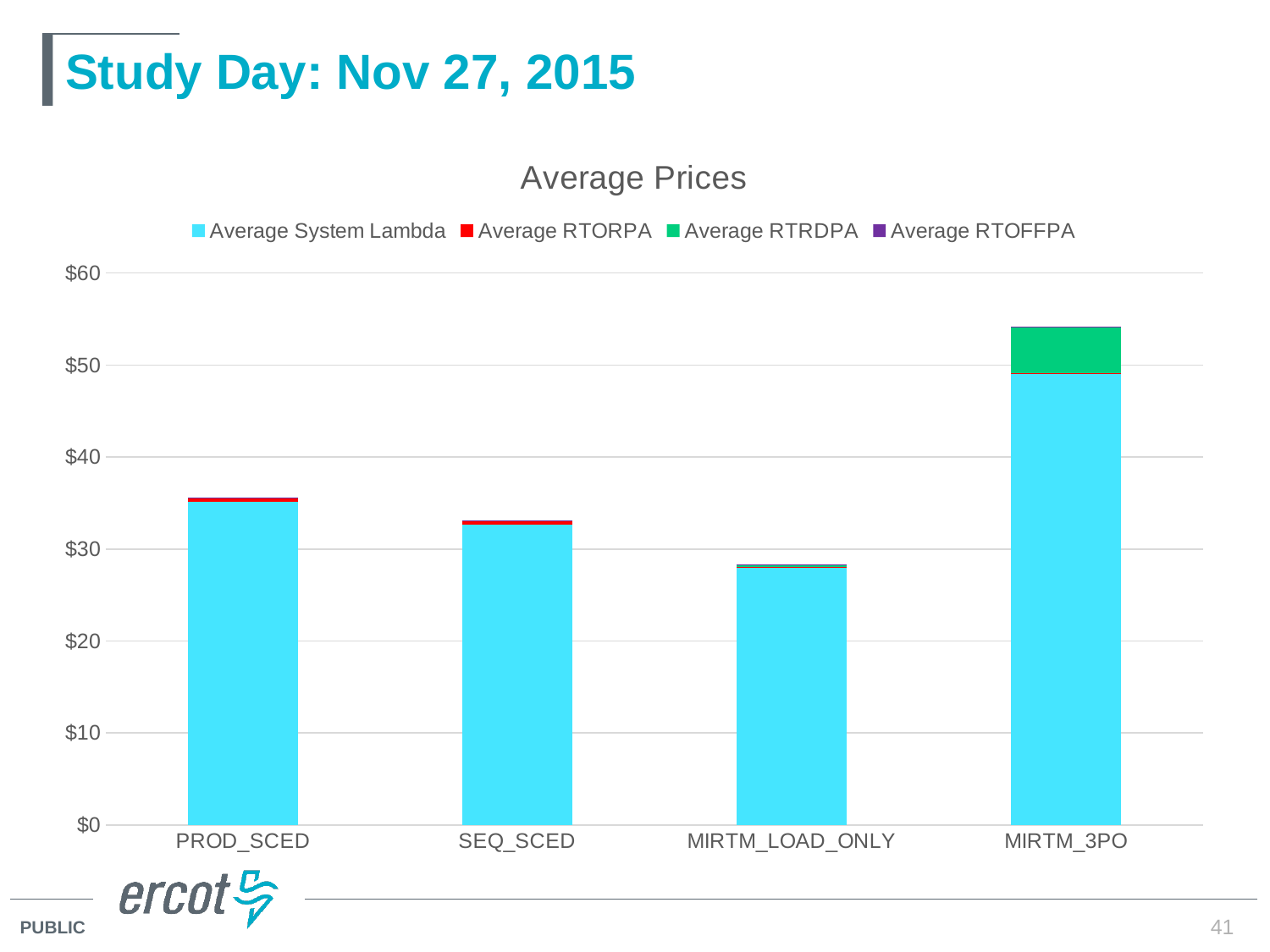
Is the Average System Lambda value for SEQ_SCED greater or less than $30? greater What kind of chart is shown on the slide? Stacked bar chart How many categories are shown on the x axis? 4 Which category has the highest total bar? MIRTM_3PO Is the total for MIRTM_LOAD_ONLY greater or less than $30? less Which category has the lowest total bar? MIRTM_LOAD_ONLY Is the total for MIRTM_3PO greater or less than $50? greater Which is larger, the total for PROD_SCED or the total for SEQ_SCED? PROD_SCED How many series does the legend list? 4 Which series is shown in green in the legend? Average RTRDPA What is the title of the chart? Average Prices